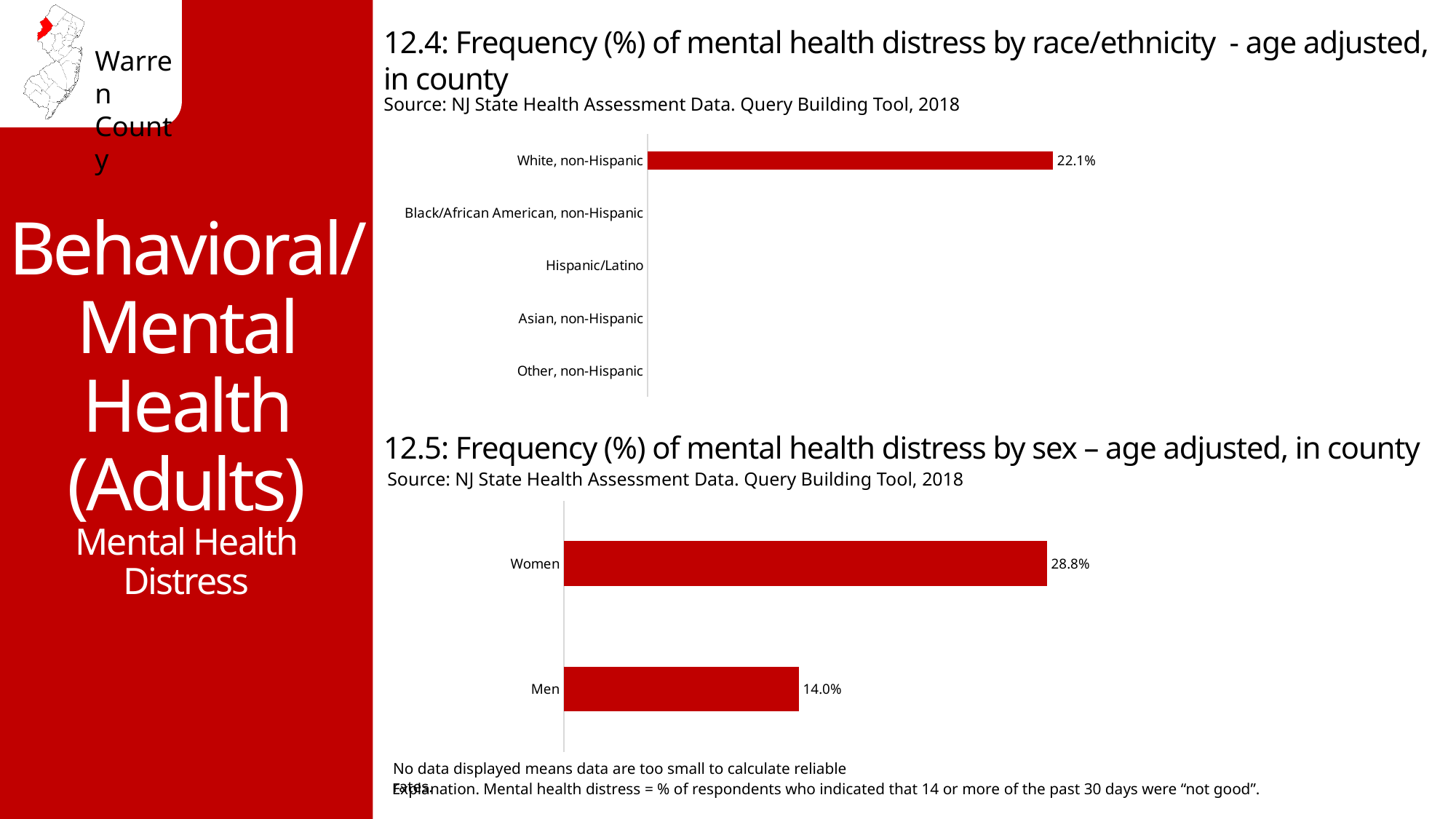
In chart 12.4 (mental health distress by race/ethnicity), which category is the only one with a bar displayed? White, non-Hispanic In chart 12.4 (mental health distress by race/ethnicity), how many race/ethnicity categories are listed on the axis? 5 In chart 12.5 (mental health distress by sex), what is the value for Men? 14.0% In chart 12.5 (mental health distress by sex), which category has the lowest value? Men In chart 12.5 (mental health distress by sex), what is the difference between the values for Women and Men? 14.8% In chart 12.5 (mental health distress by sex), how many categories are shown? 2 In chart 12.4 (mental health distress by race/ethnicity), what is the value for White, non-Hispanic? 22.1% What kind of chart is chart 12.5 (mental health distress by sex)? Bar chart In chart 12.5 (mental health distress by sex), which category has the highest value? Women What kind of chart is chart 12.4 (mental health distress by race/ethnicity)? Bar chart In chart 12.5 (mental health distress by sex), what is the value for Women? 28.8% In chart 12.5 (mental health distress by sex), which is larger, the value for Women or the value for Men? Women